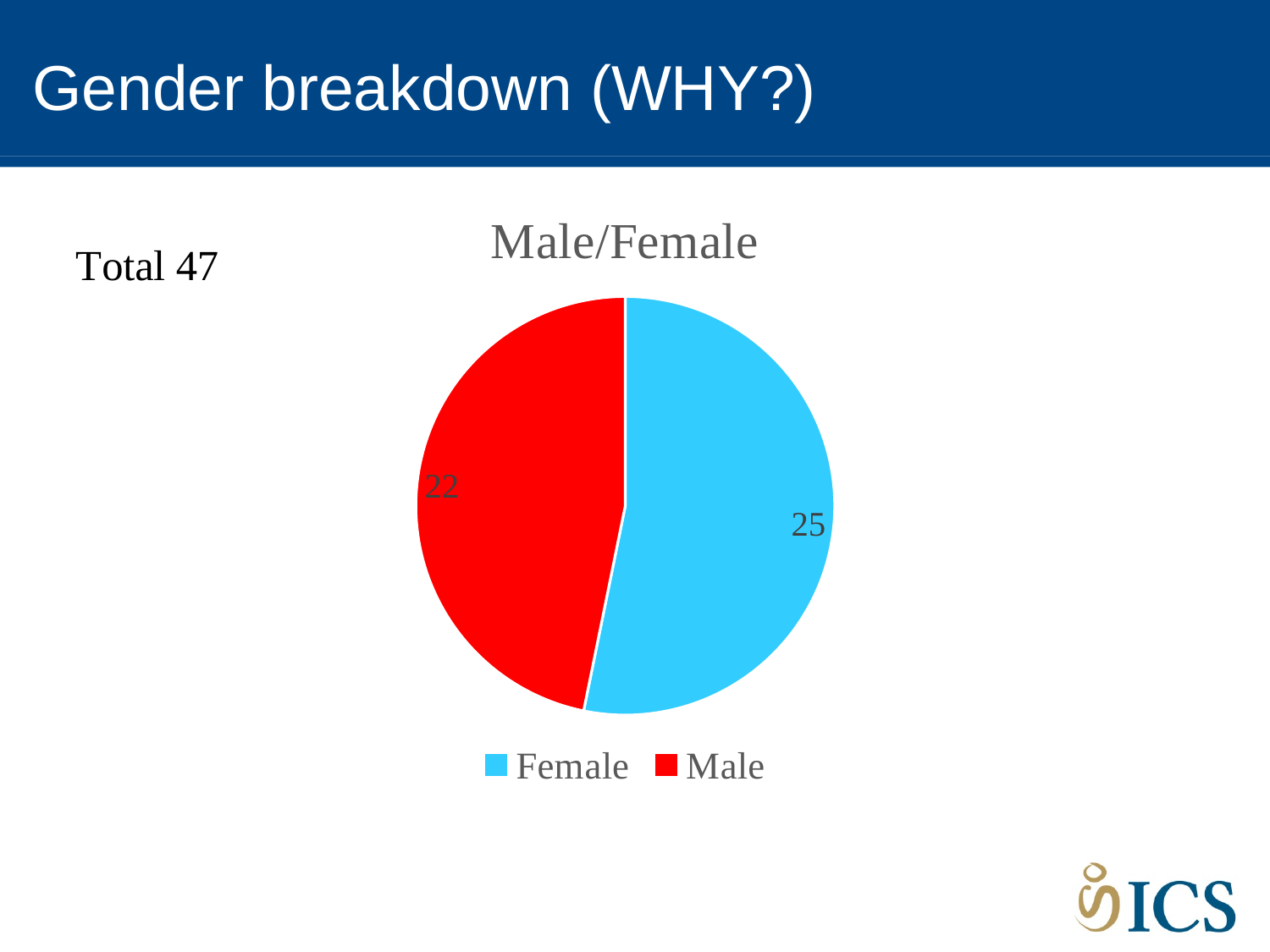
What colour is the Male slice in the pie chart? Red How many categories does the pie chart show? 2 What is the title of the chart? Male/Female What is the difference between the Female and Male values? 3 Which category has the smallest slice in the pie chart? Male Which is larger, the Female value or the Male value? Female Which category has the largest slice in the pie chart? Female What is the value for Female in the pie chart? 25 What kind of chart is shown on the slide? Pie chart What is the value for Male in the pie chart? 22 What is the total of the two slices in the pie chart? 47